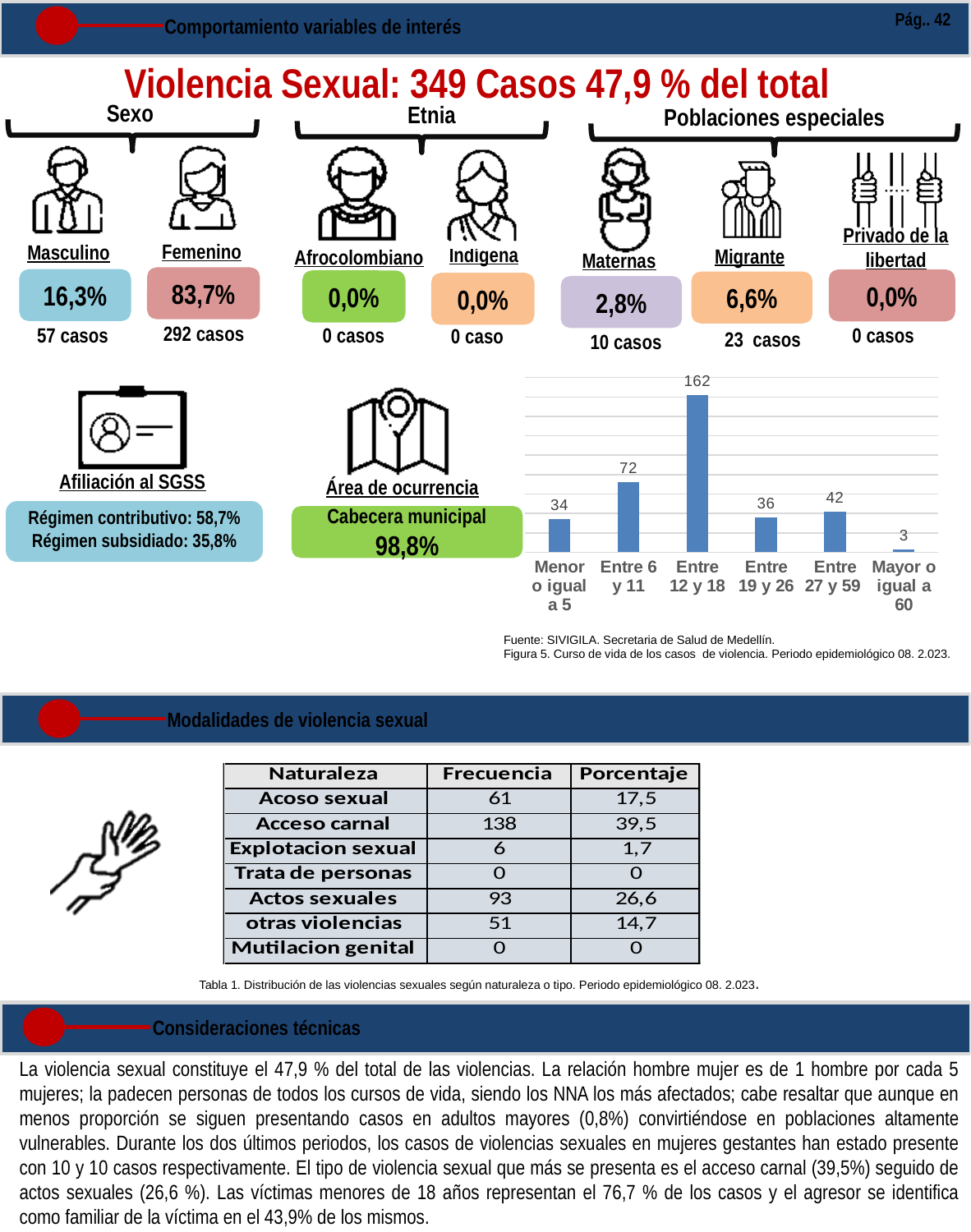
In the bar chart of cases by life stage (Figura 5), which is larger: the value for 'Entre 27 y 59' or the value for 'Entre 19 y 26'? Entre 27 y 59 What type of chart is used in Figura 5 to show cases by life stage? Bar chart In the bar chart of cases by life stage (Figura 5), what is the difference between the values for 'Entre 6 y 11' and 'Menor o igual a 5'? 38 In the bar chart of cases by life stage (Figura 5), which age group has the highest value? Entre 12 y 18 In the bar chart of cases by life stage (Figura 5), what is the difference between the values for 'Entre 12 y 18' and 'Entre 6 y 11'? 90 In the bar chart of cases by life stage (Figura 5), what is the value for 'Mayor o igual a 60'? 3 In the bar chart of cases by life stage (Figura 5), what is the value for 'Menor o igual a 5'? 34 In the bar chart of cases by life stage (Figura 5), what is the value for 'Entre 12 y 18'? 162 In the bar chart of cases by life stage (Figura 5), which age group has the lowest value? Mayor o igual a 60 In the bar chart of cases by life stage (Figura 5), how many age groups are shown? 6 According to the caption, what is the source of the data in the bar chart (Figura 5)? SIVIGILA. Secretaria de Salud de Medellín In the bar chart of cases by life stage (Figura 5), what is the value for 'Entre 27 y 59'? 42